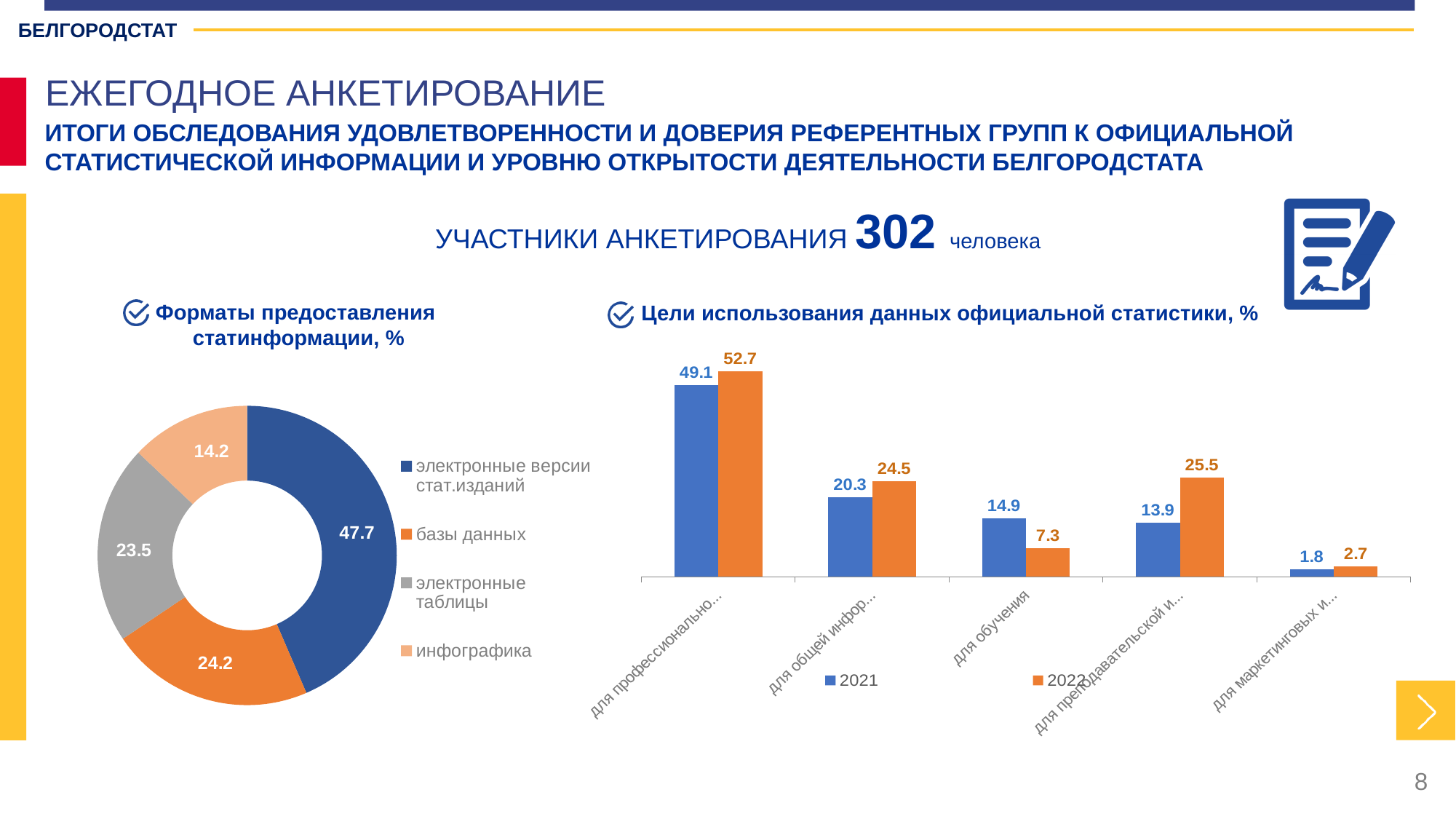
On the chart 'Цели использования данных официальной статистики, %', which category has the highest 2022 value? для профессионально... (the first category) On the chart 'Цели использования данных официальной статистики, %', what kind of chart is shown? Bar chart On the chart 'Форматы предоставления статинформации, %', how many categories does the legend list? 4 On the chart 'Цели использования данных официальной статистики, %', what is the 2021 value for 'для обучения'? 14.9 On the chart 'Форматы предоставления статинформации, %', what is the value for 'базы данных'? 24.2 On the chart 'Цели использования данных официальной статистики, %', how many series does the legend list? 2 On the chart 'Цели использования данных официальной статистики, %', what is the 2022 value for 'для обучения'? 7.3 On the chart 'Форматы предоставления статинформации, %', which category has the largest share? электронные версии стат.изданий On the chart 'Цели использования данных официальной статистики, %', what is the difference between the 2022 and 2021 values for the first category ('для профессионально...')? 3.6 On the chart 'Форматы предоставления статинформации, %', which category has the smallest share? инфографика On the chart 'Форматы предоставления статинформации, %', what kind of chart is shown? Donut (pie) chart On the chart 'Цели использования данных официальной статистики, %', for 'для обучения', which is larger: the 2021 value or the 2022 value? 2021